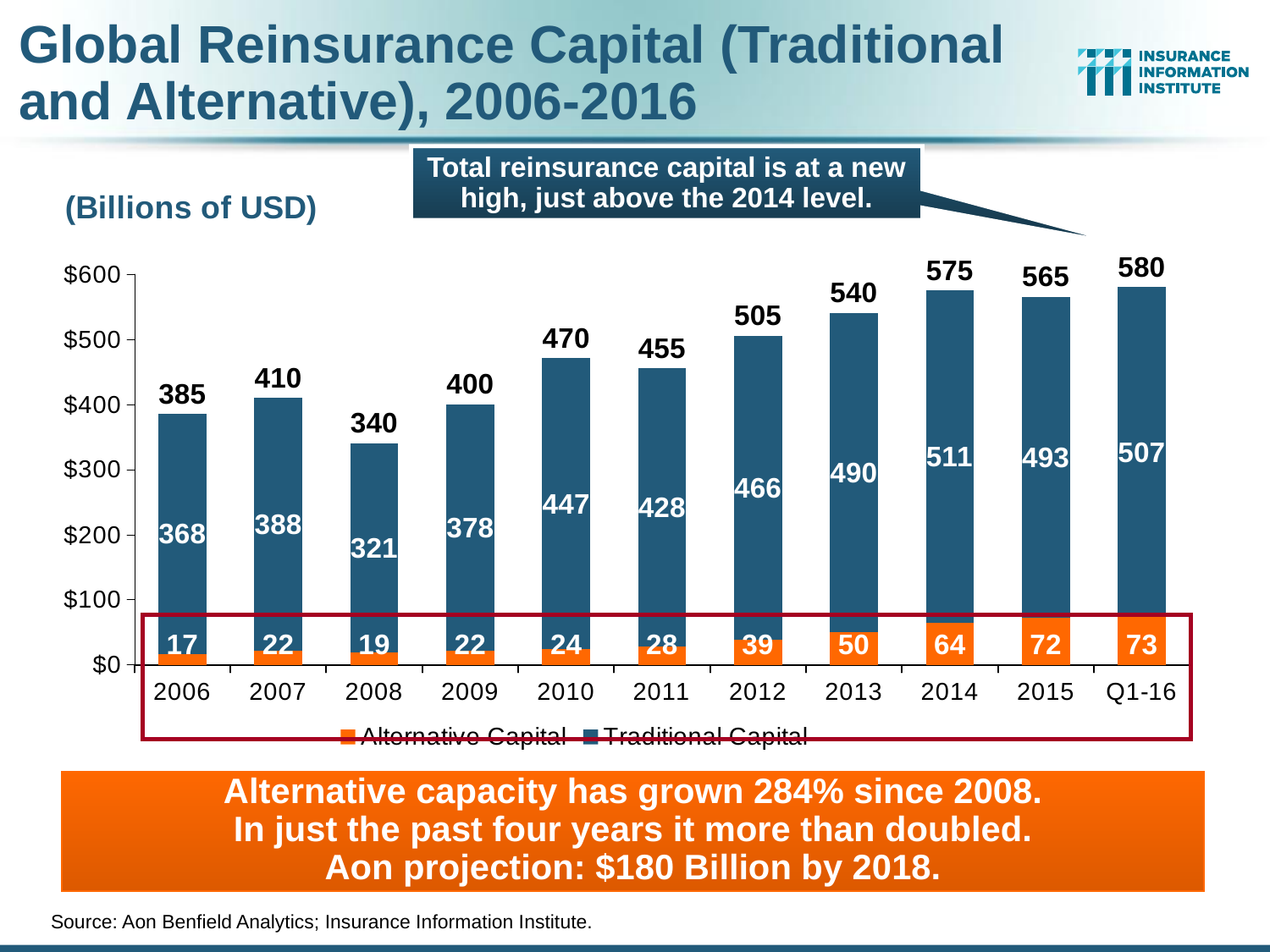
What is the Alternative Capital value for 2014? 64 Is the total reinsurance capital for 2010 greater or less than $400? greater What is the total reinsurance capital shown for Q1-16? 580 What is the Traditional Capital value for 2012? 466 What kind of chart is shown on the slide? Stacked bar chart Which is larger, the Alternative Capital value for 2013 or for 2012? 2013 Which colour represents Alternative Capital in the chart? Orange Which year has the lowest total reinsurance capital? 2008 Which period has the highest Alternative Capital value? Q1-16 How many series does the legend list? 2 What is the difference between the Traditional Capital values for 2014 and 2015? 18 How many periods are shown on the x axis? 11